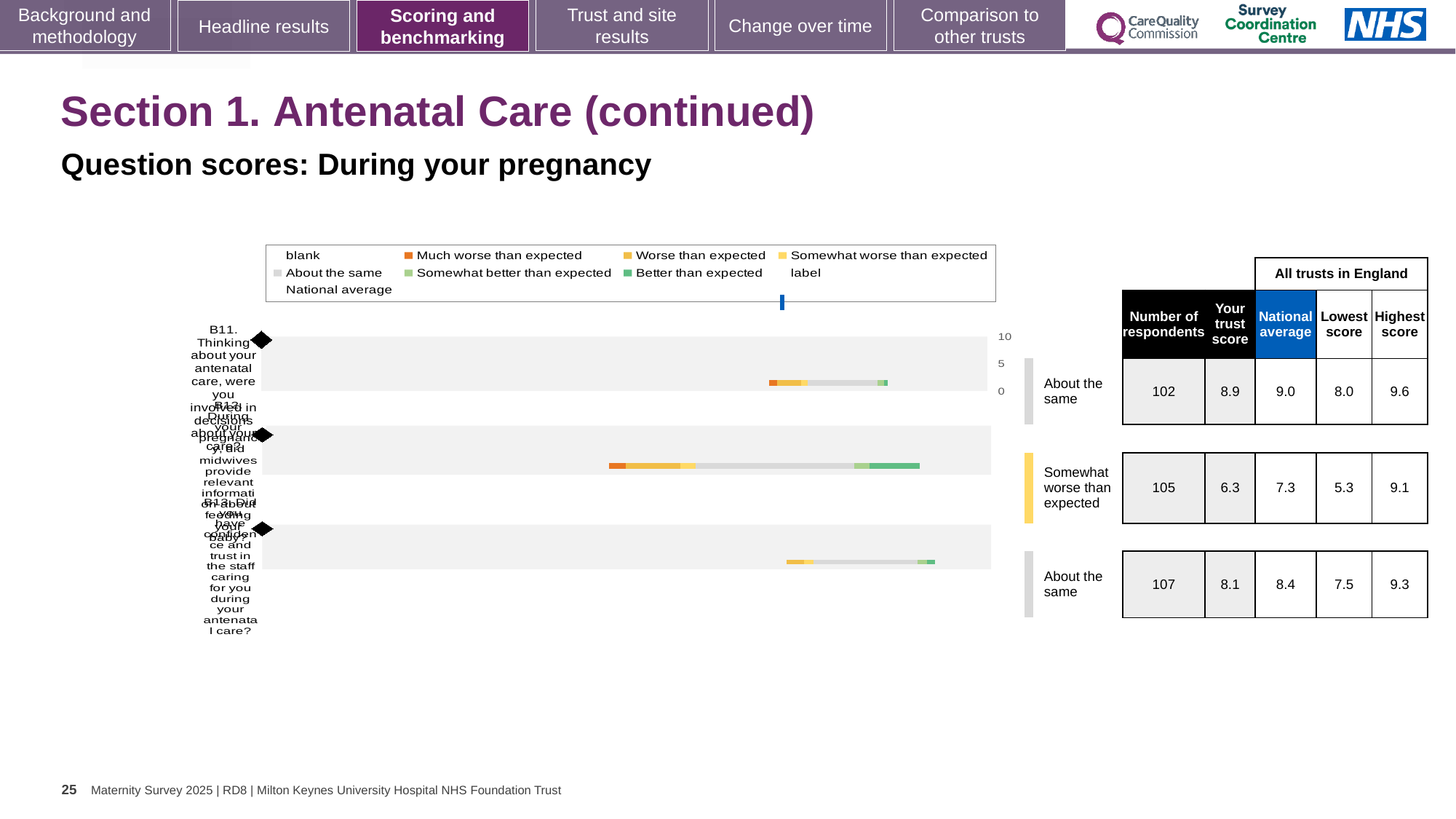
For question B12, which is larger: the trust score or the national average? National average How many questions (bars) are plotted in the chart? 3 What colour does the legend use for 'Much worse than expected'? orange Which question has the lowest trust score? B12 How many respondents are listed for question B13? 107 How many entries does the chart legend list? 9 What is the difference between the national average and the trust score for question B11? 0.1 What is the national average for question B12? 7.3 What kind of chart is shown on the slide? bar chart What is the highest score across all trusts in England for question B13? 9.3 What benchmark category is shown for question B12? Somewhat worse than expected What is the 'Your trust score' for question B11? 8.9